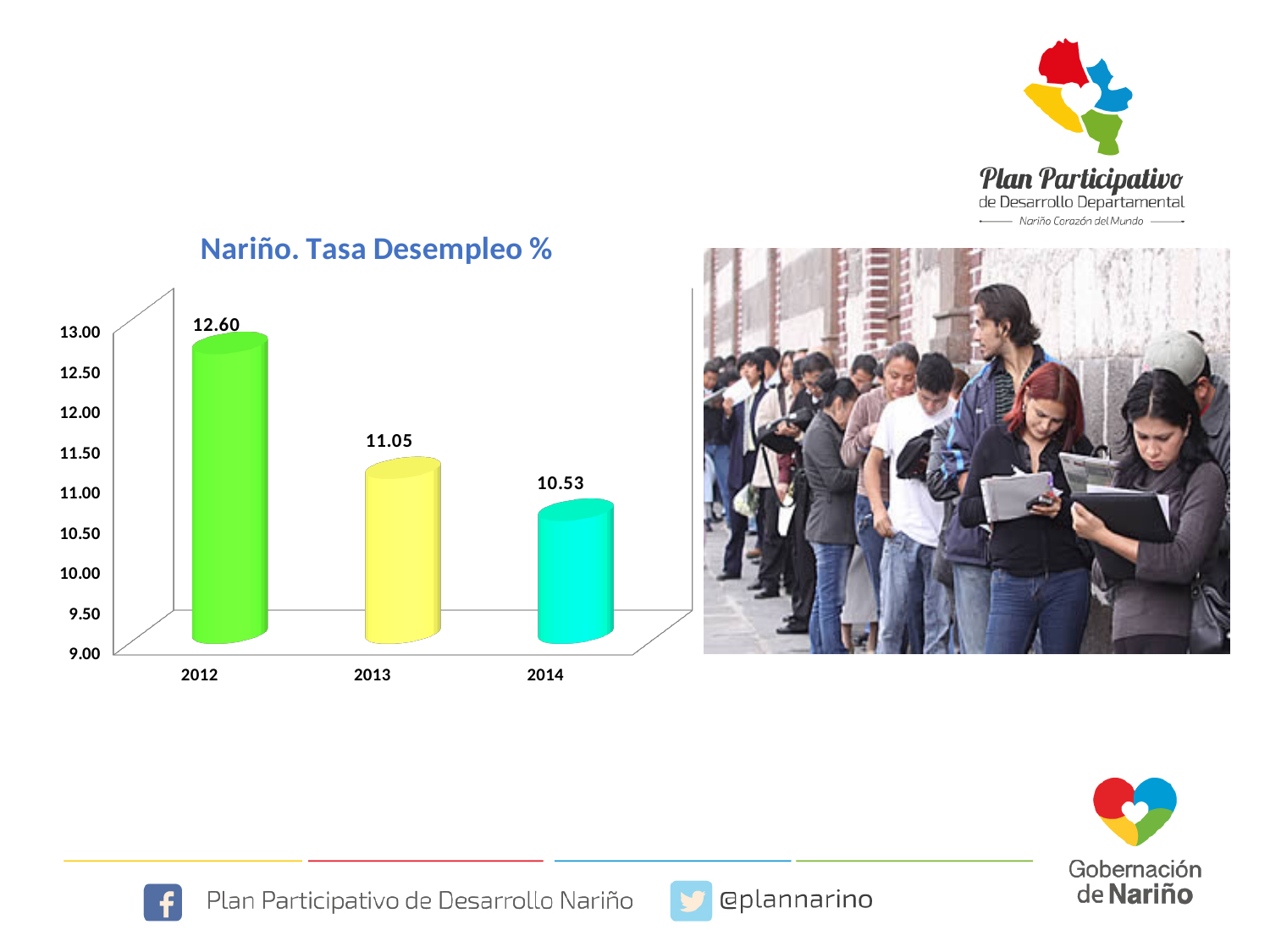
What is the unemployment rate shown for 2013? 11.05 How many years are shown on the chart? 3 What is the difference between the 2012 and 2014 unemployment rates? 2.07 Which year has the highest unemployment rate? 2012 Which year has a higher unemployment rate, 2013 or 2014? 2013 Which year has the lowest unemployment rate? 2014 What is the unemployment rate shown for 2014? 10.53 What is the difference between the 2012 and 2013 unemployment rates? 1.55 Is the value for 2013 greater or less than 11.00? greater What kind of chart is shown on the slide? bar chart Do the values rise or fall from 2012 to 2014? fall What is the unemployment rate shown for 2012? 12.60